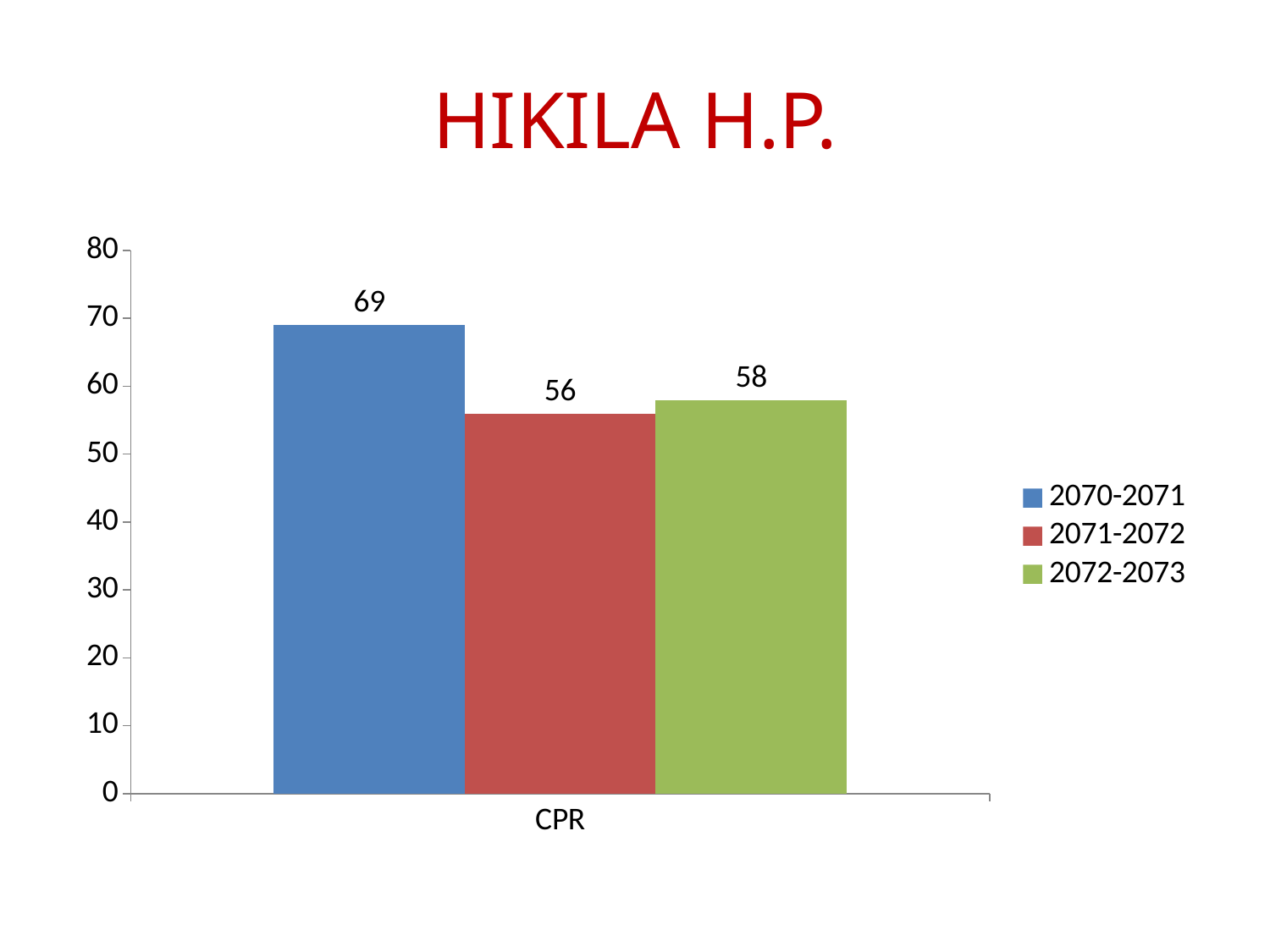
What is the difference between the CPR values for 2072-2073 and 2071-2072? 2 What is the difference between the CPR values for 2070-2071 and 2071-2072? 13 How many series does the legend list? 3 What kind of chart is shown on the slide? bar chart Which series has the lowest CPR value? 2071-2072 What is the CPR value for 2071-2072? 56 What is the CPR value for 2070-2071? 69 What is the CPR value for 2072-2073? 58 What is the title of the slide? HIKILA H.P. Which is larger, the CPR value for 2070-2071 or for 2072-2073? 2070-2071 Is the CPR value for 2071-2072 greater or less than 60? less Which series has the highest CPR value? 2070-2071